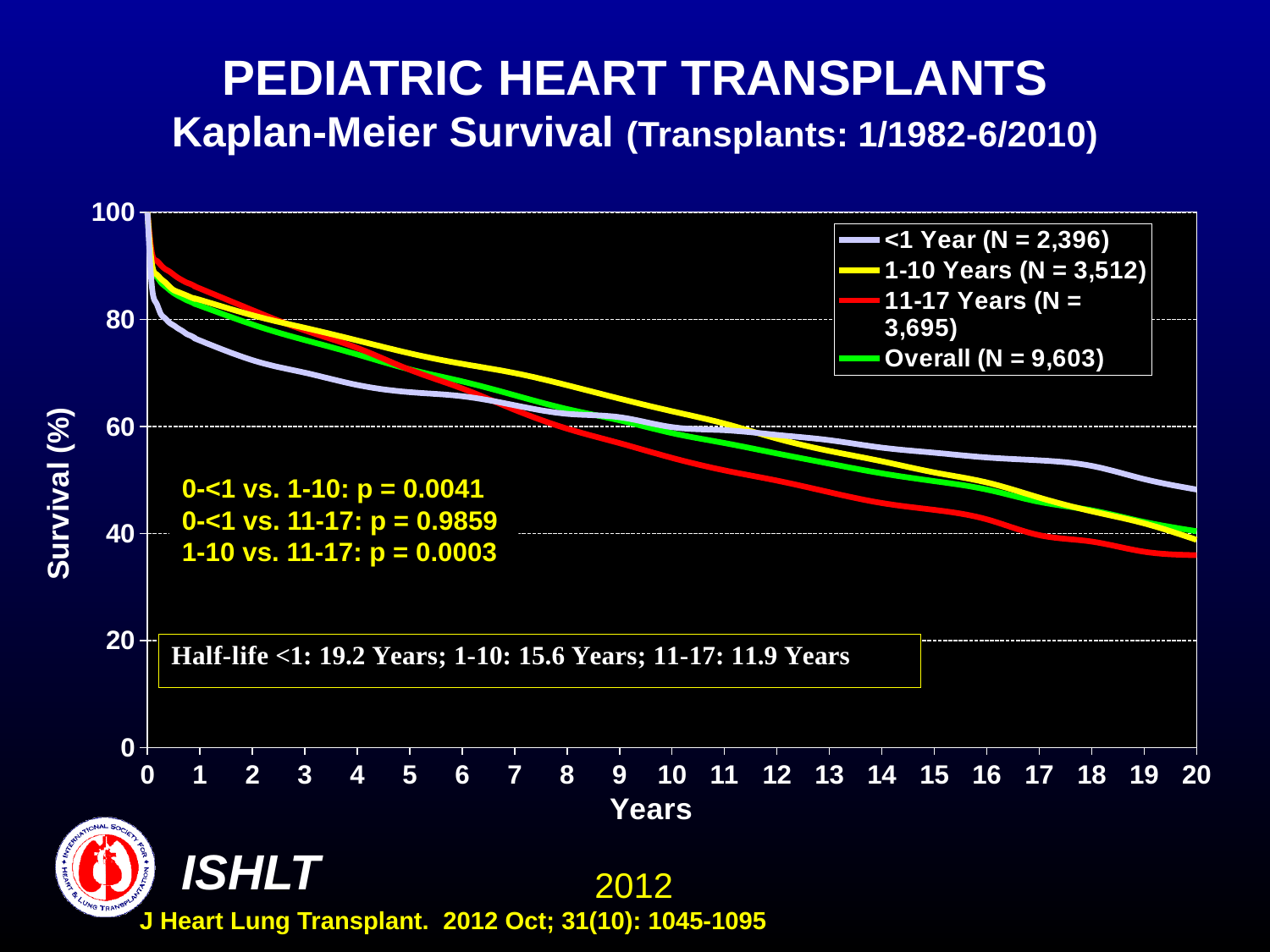
What is the half-life for the <1 group according to the text box on the chart? 19.2 Years Is the survival value for the 11-17 Years group at 20 years greater or less than 40? less Is the survival value for the <1 Year group at 20 years greater or less than 40? greater Is the survival value for the 1-10 Years group at 5 years greater or less than 60? greater What is the N for the 1-10 Years group shown in the legend? 3,512 What is the N for the Overall group shown in the legend? 9,603 At 20 years, which group has higher survival: <1 Year or 11-17 Years? <1 Year What kind of chart is shown on the slide? line chart Do the survival curves rise or fall as years increase along the x axis? fall How many series does the legend list? 4 What is the p-value for the comparison of 1-10 vs. 11-17 shown on the chart? 0.0003 At 5 years, which group has higher survival: 1-10 Years or <1 Year? 1-10 Years